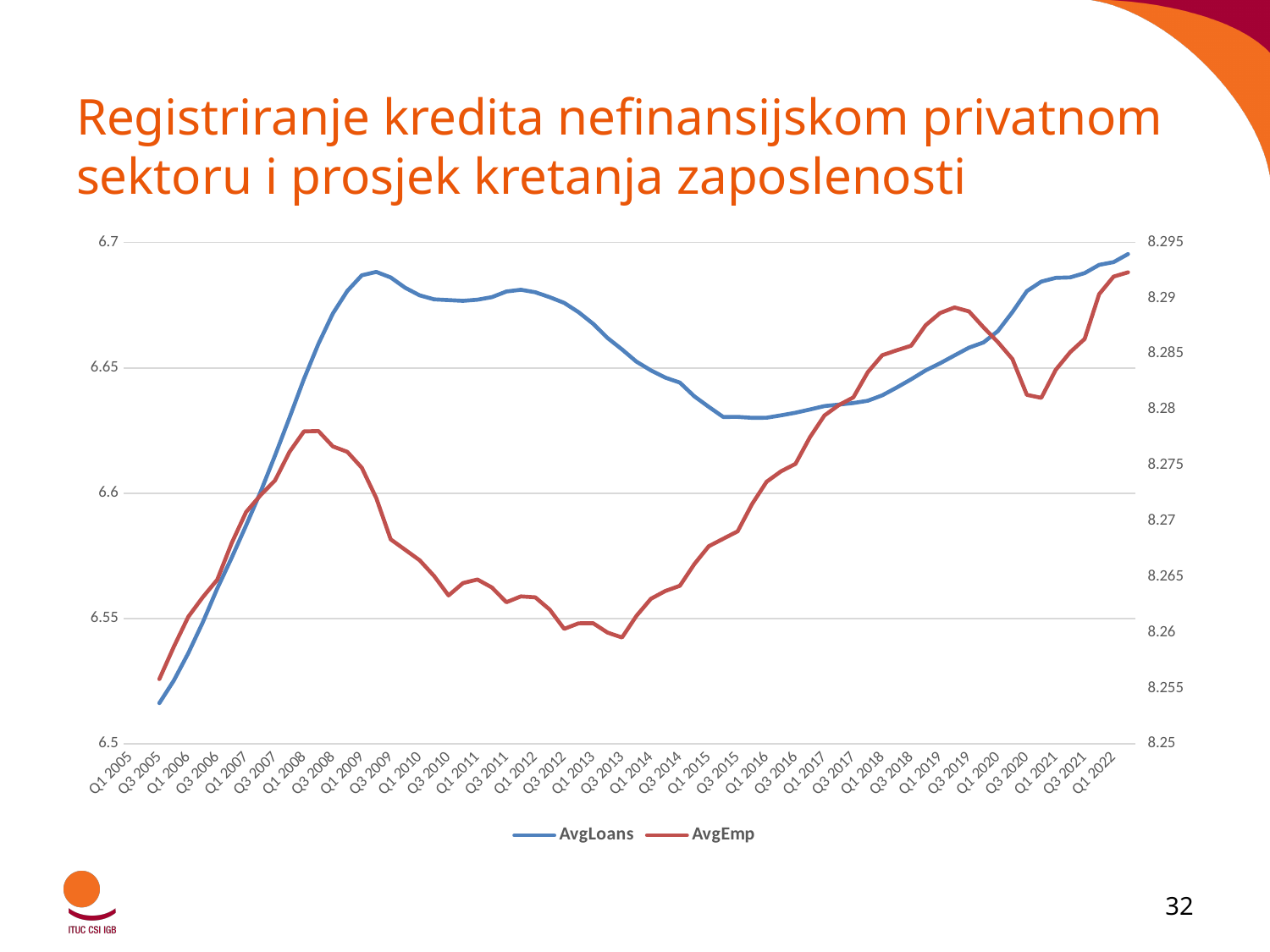
Which is larger for AvgLoans: the value at Q1 2009 or the value at Q1 2015? Q1 2009 At which quarter is the AvgLoans series at its lowest? Q3 2005 Is the AvgLoans value at Q1 2015 greater or less than 6.6? greater Is the AvgLoans value at Q1 2009 greater or less than 6.65? greater Is the AvgEmp value at Q1 2016 greater or less than 8.27? greater What kind of chart is shown on the slide? line chart Does the AvgLoans series rise or fall between Q1 2005 and Q1 2009? rise Does the AvgEmp series rise or fall between Q1 2008 and Q1 2013? fall What is the highest value shown on the right-hand vertical axis? 8.295 Which series is drawn in blue? AvgLoans How many series does the legend list? 2